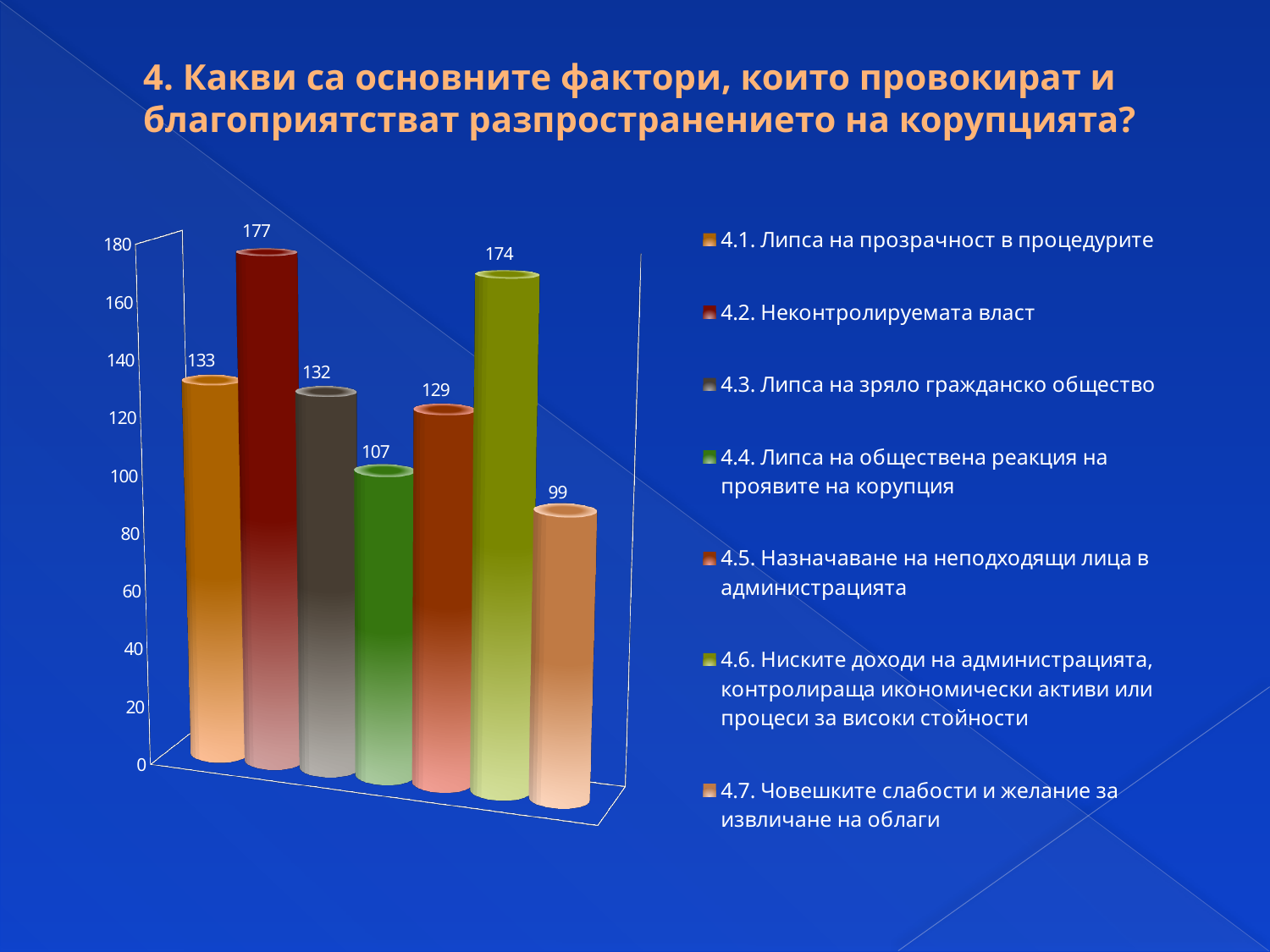
Which legend entry has the highest value? 4.2. Неконтролируемата власт What is the value for "4.1. Липса на прозрачност в процедурите"? 133 What kind of chart is shown on the slide? bar chart What is the difference between the values for "4.2. Неконтролируемата власт" and "4.6. Ниските доходи на администрацията, контролираща икономически активи или процеси за високи стойности"? 3 How many entries does the legend list? 7 What is the value for "4.2. Неконтролируемата власт"? 177 What is the value for "4.4. Липса на обществена реакция на проявите на корупция"? 107 How many bars are plotted in the chart? 7 Is the value for "4.4. Липса на обществена реакция на проявите на корупция" greater or less than 120? less Which is larger, the value for "4.3. Липса на зряло гражданско общество" or the value for "4.5. Назначаване на неподходящи лица в администрацията"? 4.3. Липса на зряло гражданско общество What is the value for "4.7. Човешките слабости и желание за извличане на облаги"? 99 Which legend entry has the lowest value? 4.7. Човешките слабости и желание за извличане на облаги